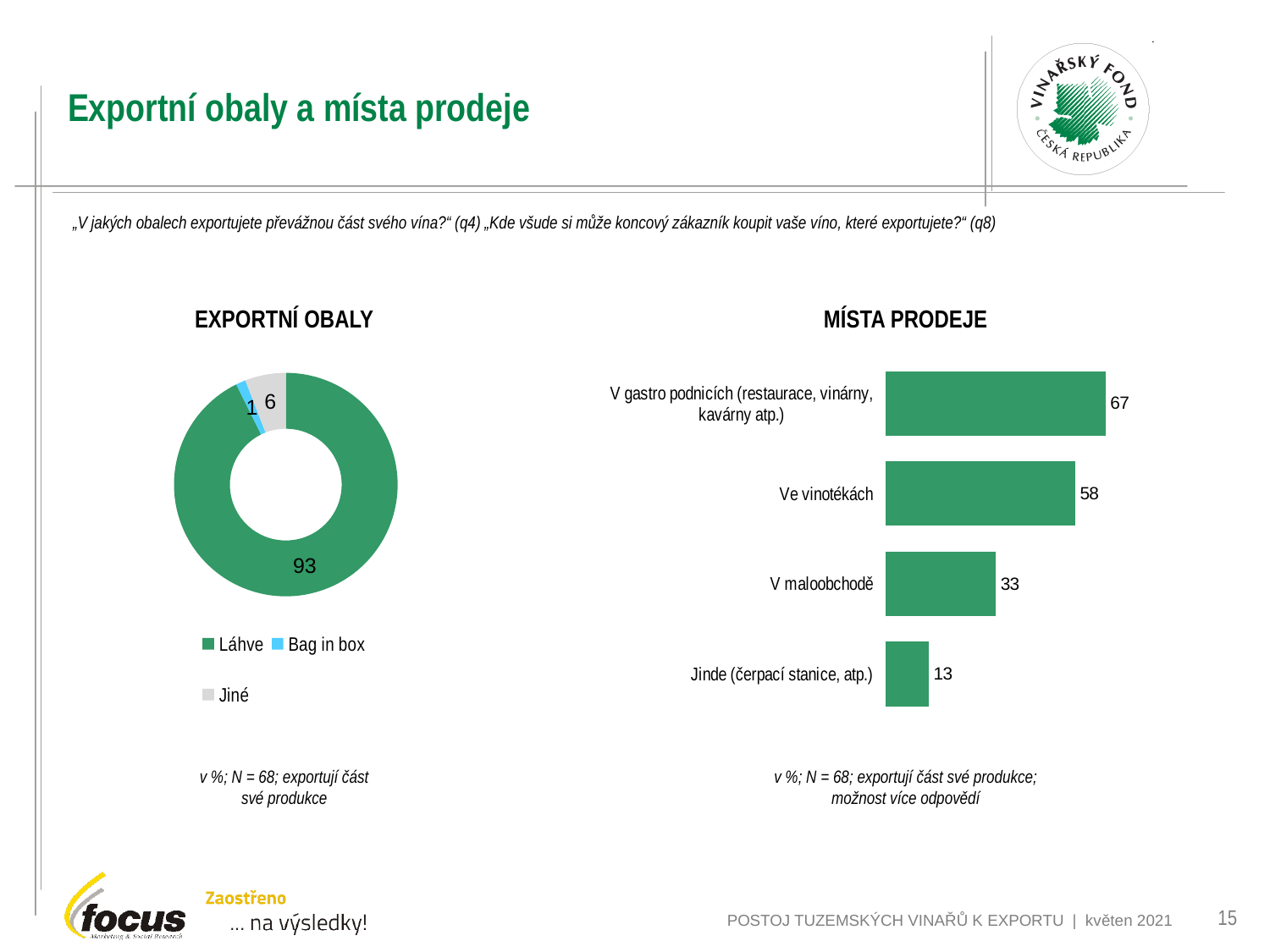
In the EXPORTNÍ OBALY chart, what is the value for Jiné? 6 In the MÍSTA PRODEJE chart, what is the value for Ve vinotékách? 58 In the EXPORTNÍ OBALY chart, what is the value for Láhve? 93 In the MÍSTA PRODEJE chart, what is the difference between the values for V gastro podnicích and V maloobchodě? 34 In the MÍSTA PRODEJE chart, which is larger: Ve vinotékách or V maloobchodě? Ve vinotékách In the EXPORTNÍ OBALY chart, which category has the smallest share? Bag in box What kind of chart is the EXPORTNÍ OBALY chart? Donut chart What kind of chart is the MÍSTA PRODEJE chart? Bar chart In the MÍSTA PRODEJE chart, what is the value for Jinde (čerpací stanice, atp.)? 13 In the MÍSTA PRODEJE chart, which category has the highest value? V gastro podnicích (restaurace, vinárny, kavárny atp.) In the EXPORTNÍ OBALY chart, how many entries does the legend list? 3 How many categories are shown in the MÍSTA PRODEJE chart? 4